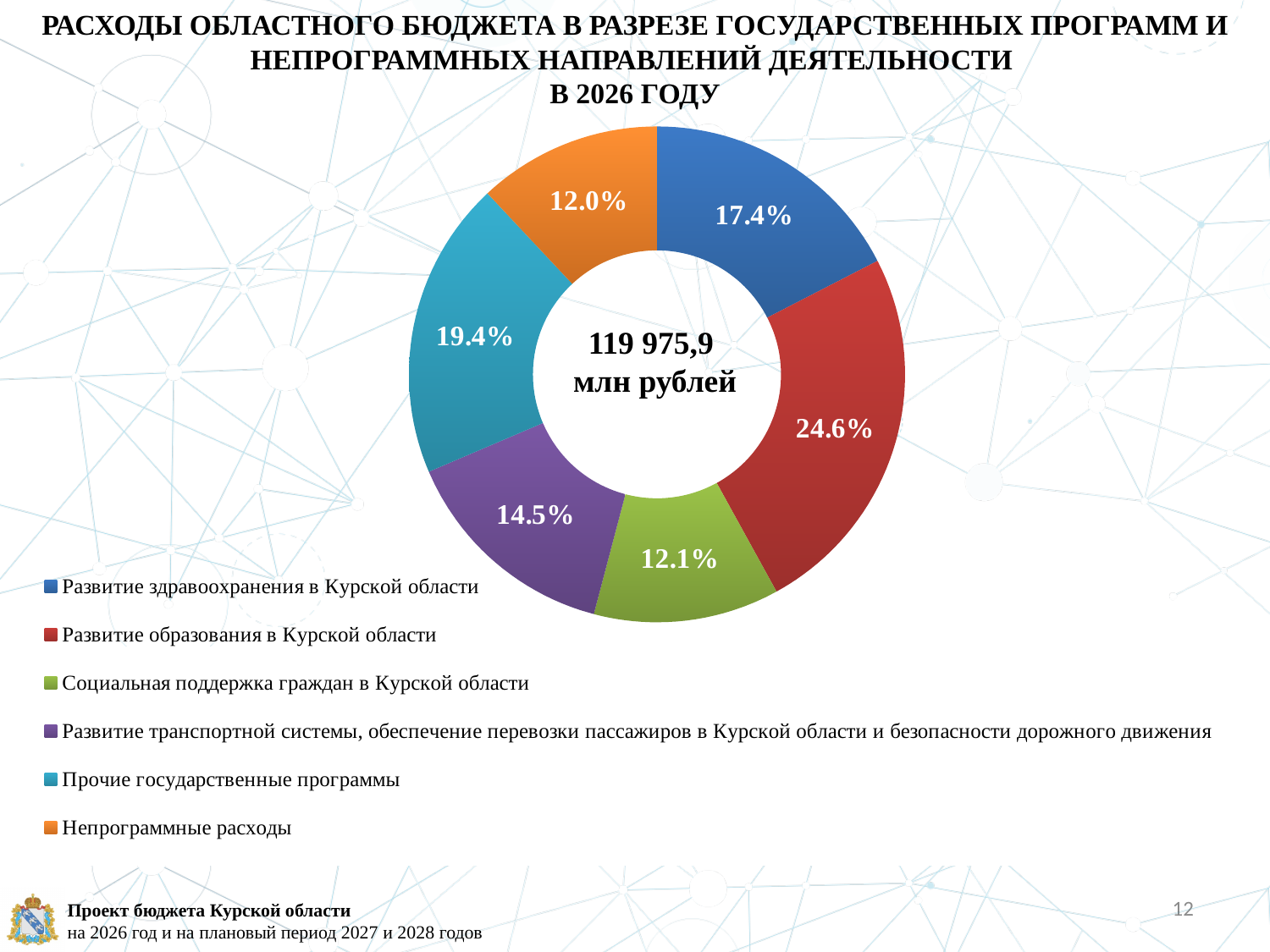
What total amount is written in the centre of the chart? 119 975,9 млн рублей What share is labelled for «Непрограммные расходы»? 12.0% What colour represents «Социальная поддержка граждан в Курской области» in the chart? Green How many categories does the chart show? 6 What percentage does the chart show for «Прочие государственные программы»? 19.4% What percentage is shown for «Развитие здравоохранения в Курской области»? 17.4% Which program has the largest share of expenditure in the chart? Развитие образования в Курской области Which has a larger share: «Прочие государственные программы» or «Развитие транспортной системы, обеспечение перевозки пассажиров в Курской области и безопасности дорожного движения»? Прочие государственные программы What type of chart is shown on the slide? Donut (pie) chart Which category has the smallest share in the chart? Непрограммные расходы What share of the 2026 regional budget expenditure goes to «Развитие образования в Курской области»? 24.6% What is the difference in percentage points between the shares for «Развитие образования в Курской области» and «Развитие здравоохранения в Курской области»? 7.2